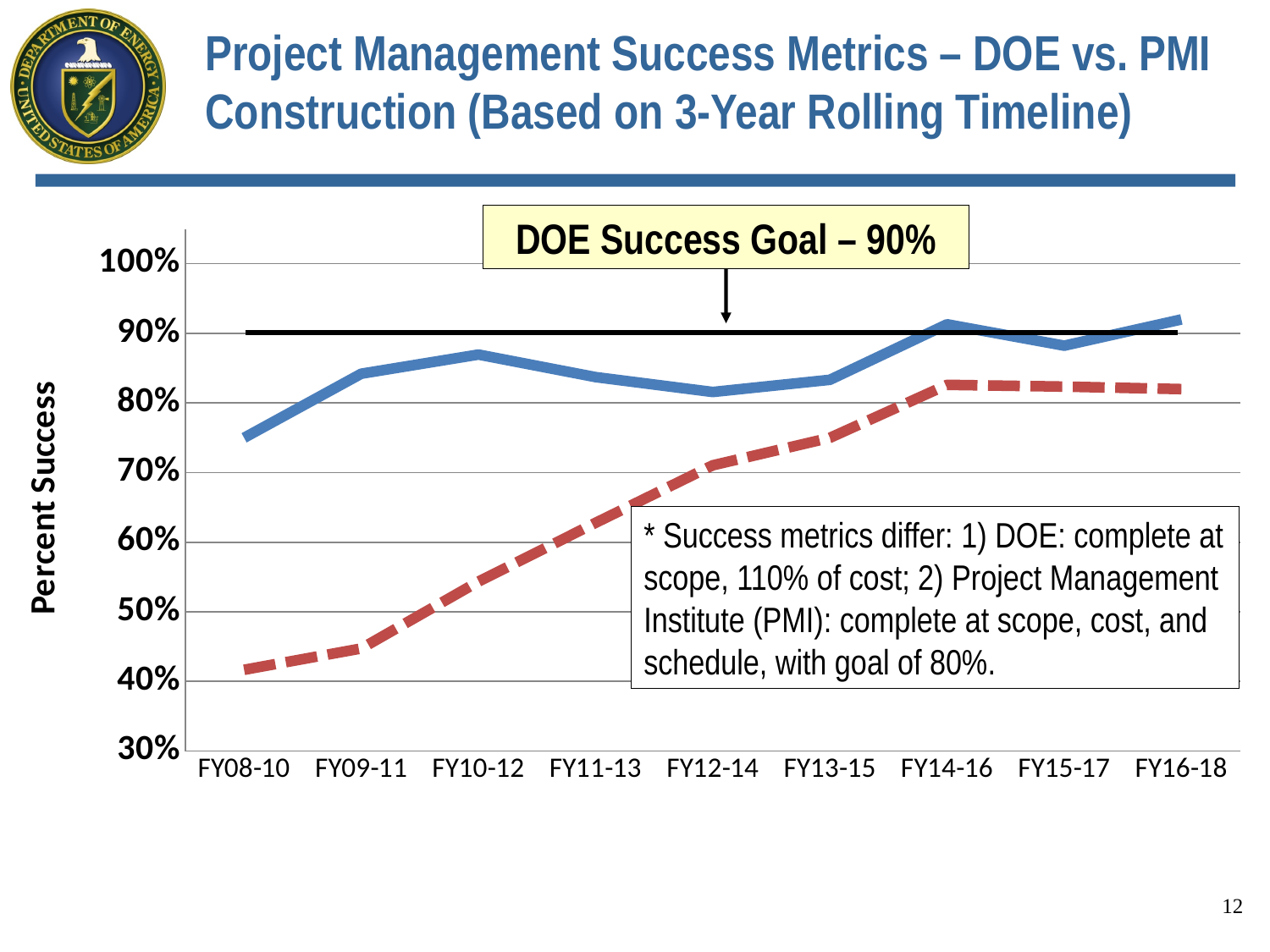
Is the value of the red dashed line for FY14-16 greater or less than 80%? greater At FY08-10, which line has the higher value, the blue solid line or the red dashed line? the blue solid line What value does the DOE Success Goal line represent? 90% In which period is the red dashed line at its lowest value? FY08-10 Is the value of the red dashed line for FY08-10 greater or less than 50%? less How many fiscal-year periods are plotted along the x axis? 9 What is the title of the y axis? Percent Success Is the value of the blue solid line for FY10-12 greater or less than 90%? less What kind of chart is shown on the slide? line chart Does the red dashed line generally rise or fall from FY08-10 to FY16-18? rise